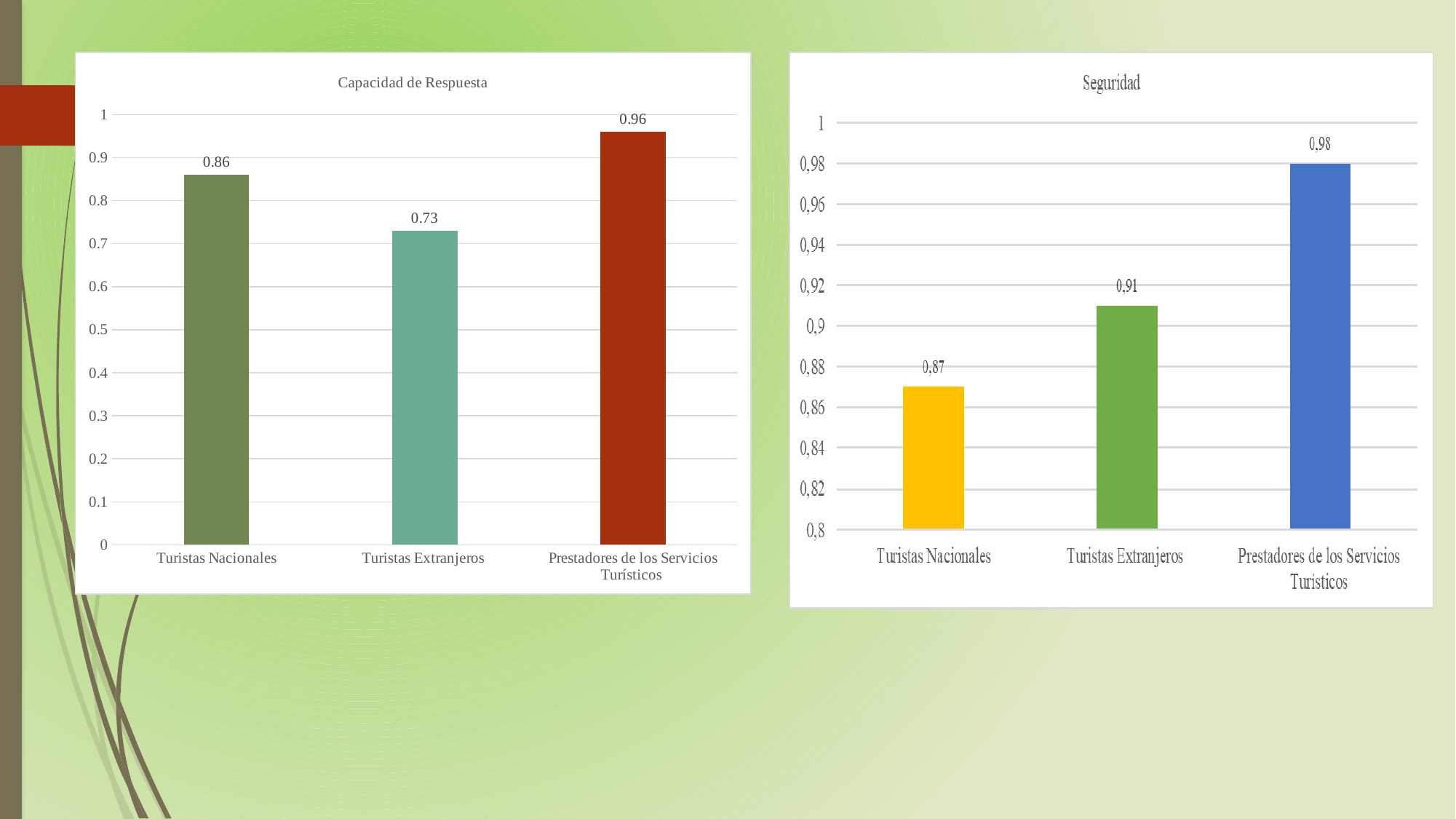
What type of chart is the 'Capacidad de Respuesta' chart? Bar chart In the 'Seguridad' chart, is the value for Turistas Extranjeros greater or less than 0,9? greater In the 'Seguridad' chart, what is the difference between the values for Turistas Extranjeros and Turistas Nacionales? 0,04 In the 'Capacidad de Respuesta' chart, what is the value for Turistas Nacionales? 0.86 In the 'Capacidad de Respuesta' chart, what is the difference between the values for Prestadores de los Servicios Turísticos and Turistas Extranjeros? 0.23 In the 'Seguridad' chart, what is the value for Prestadores de los Servicios Turísticos? 0,98 In the 'Seguridad' chart, what is the value for Turistas Nacionales? 0,87 In the 'Capacidad de Respuesta' chart, what is the value for Turistas Extranjeros? 0.73 In the 'Capacidad de Respuesta' chart, which category has the highest value? Prestadores de los Servicios Turísticos How many categories are shown in the 'Seguridad' chart? 3 In the 'Capacidad de Respuesta' chart, which category has the lowest value? Turistas Extranjeros In the 'Seguridad' chart, which category has the lowest value? Turistas Nacionales